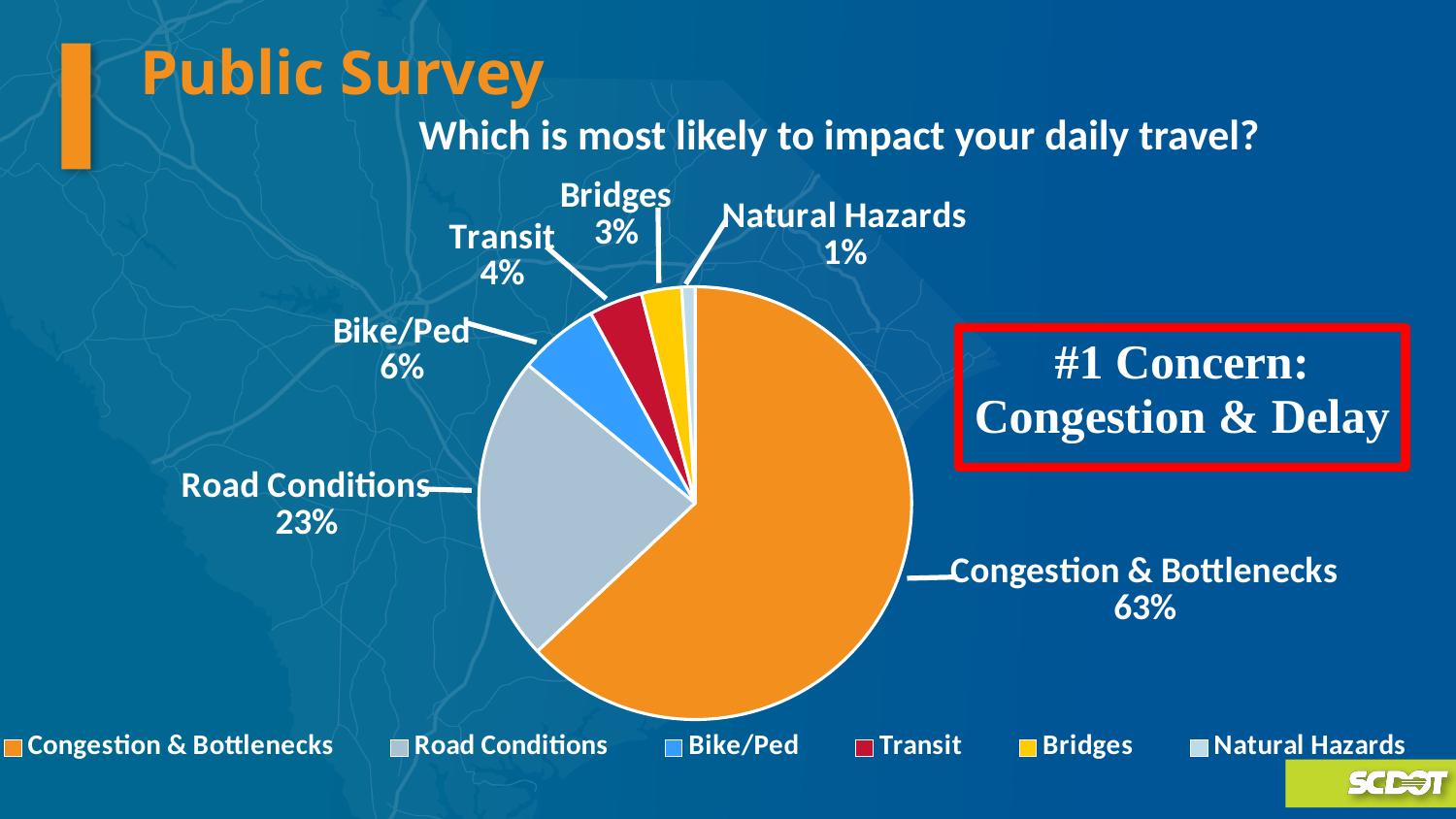
What percentage of respondents chose Transit? 4% What kind of chart is shown on the slide? pie chart What percentage of respondents chose Congestion & Bottlenecks? 63% Which is larger, the share for Bike/Ped or the share for Bridges? Bike/Ped What question does the chart's title ask? Which is most likely to impact your daily travel? Which category has the smallest share of the pie? Natural Hazards How many categories are shown in the pie chart? 6 What percentage of respondents chose Bike/Ped? 6% Which category has the largest share of the pie? Congestion & Bottlenecks What percentage of respondents chose Road Conditions? 23% What percentage of respondents chose Natural Hazards? 1% What is the difference in percentage points between Congestion & Bottlenecks and Road Conditions? 40